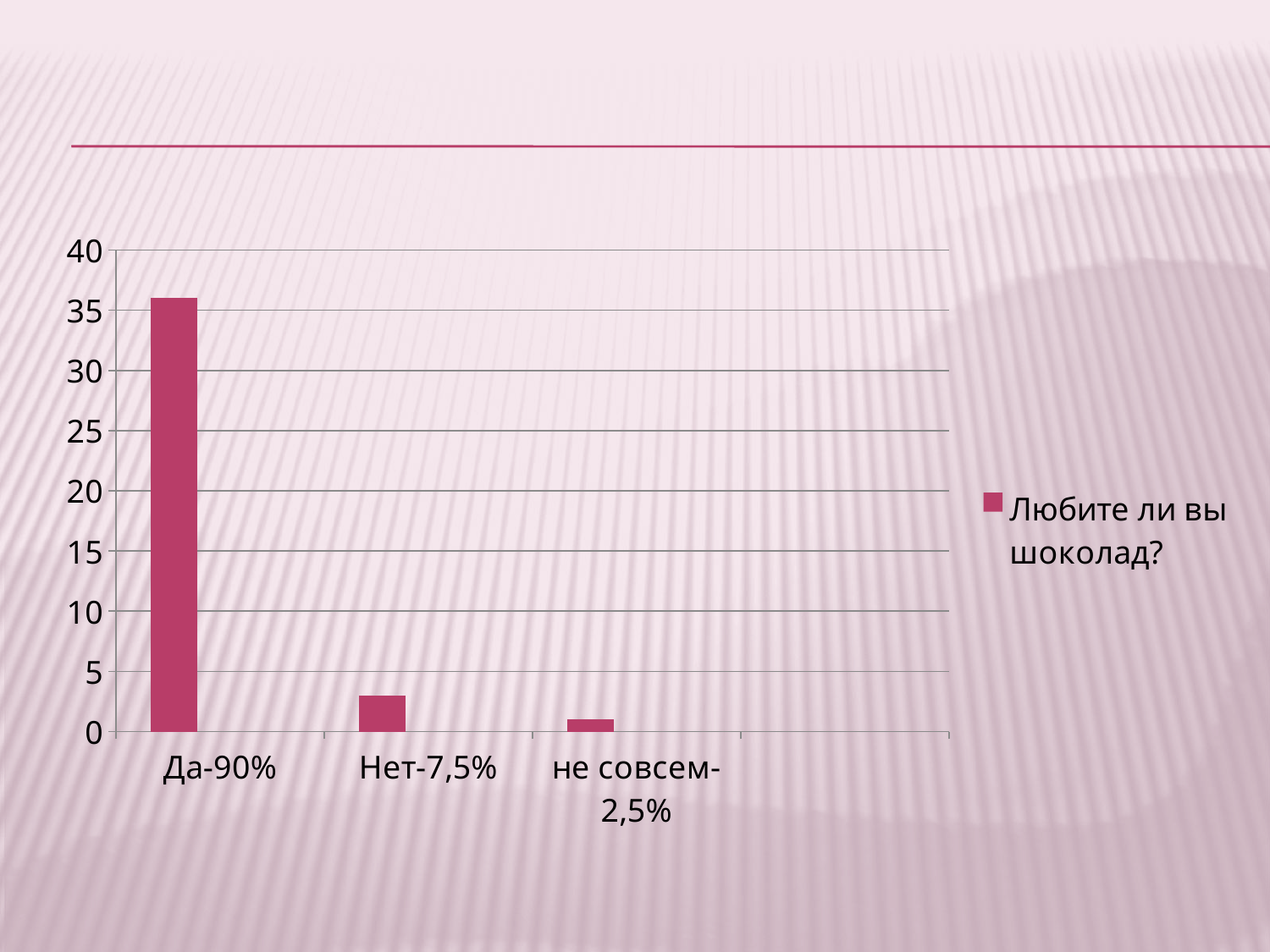
Which category has the highest bar in the chart? Да-90% Which bar is taller, Нет-7,5% or не совсем-2,5%? Нет-7,5% Which category has the lowest bar in the chart? не совсем-2,5% How many series does the chart's legend list? 1 What kind of chart is shown on the slide? bar chart Which bar is taller, Да-90% or Нет-7,5%? Да-90% Is the value for Да-90% greater or less than 30? greater Is the value for Нет-7,5% greater or less than 5? less What is the legend entry for the series in the chart? Любите ли вы шоколад? Is the value for не совсем-2,5% greater or less than 5? less How many categories are shown on the x axis of the chart? 3 Do the bar values rise or fall from left to right along the x axis? fall